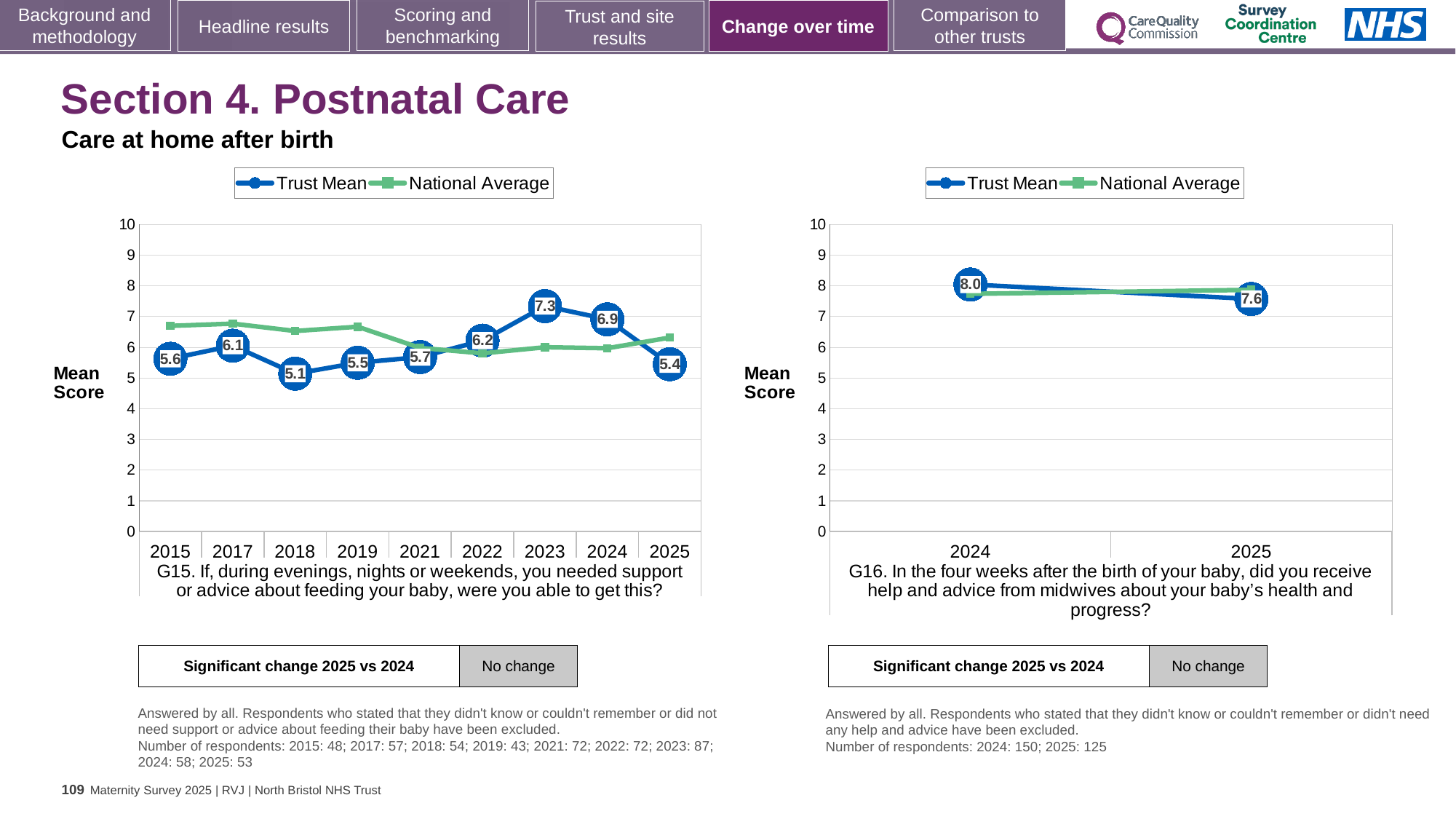
How many series does the legend of the right chart (G16) list? 2 In the left chart (G15), how many years are shown on the x axis? 9 In the left chart (G15), is the Trust Mean score higher in 2017 or in 2018? 2017 In the left chart (G15), what is the Trust Mean score for 2025? 5.4 In the left chart (G15), what is the difference between the Trust Mean scores for 2024 and 2025? 1.5 In the left chart (G15), is the National Average for 2015 greater or less than 6? greater In the right chart (G16), what is the Trust Mean score for 2024? 8.0 In the right chart (G16), does the Trust Mean rise or fall from 2024 to 2025? fall In the left chart (G15), which year has the highest Trust Mean score? 2023 In the right chart (G16), what is the difference between the Trust Mean scores for 2024 and 2025? 0.4 In the left chart (G15), which year has the lowest Trust Mean score? 2018 In the left chart (G15), what is the Trust Mean score for 2023? 7.3